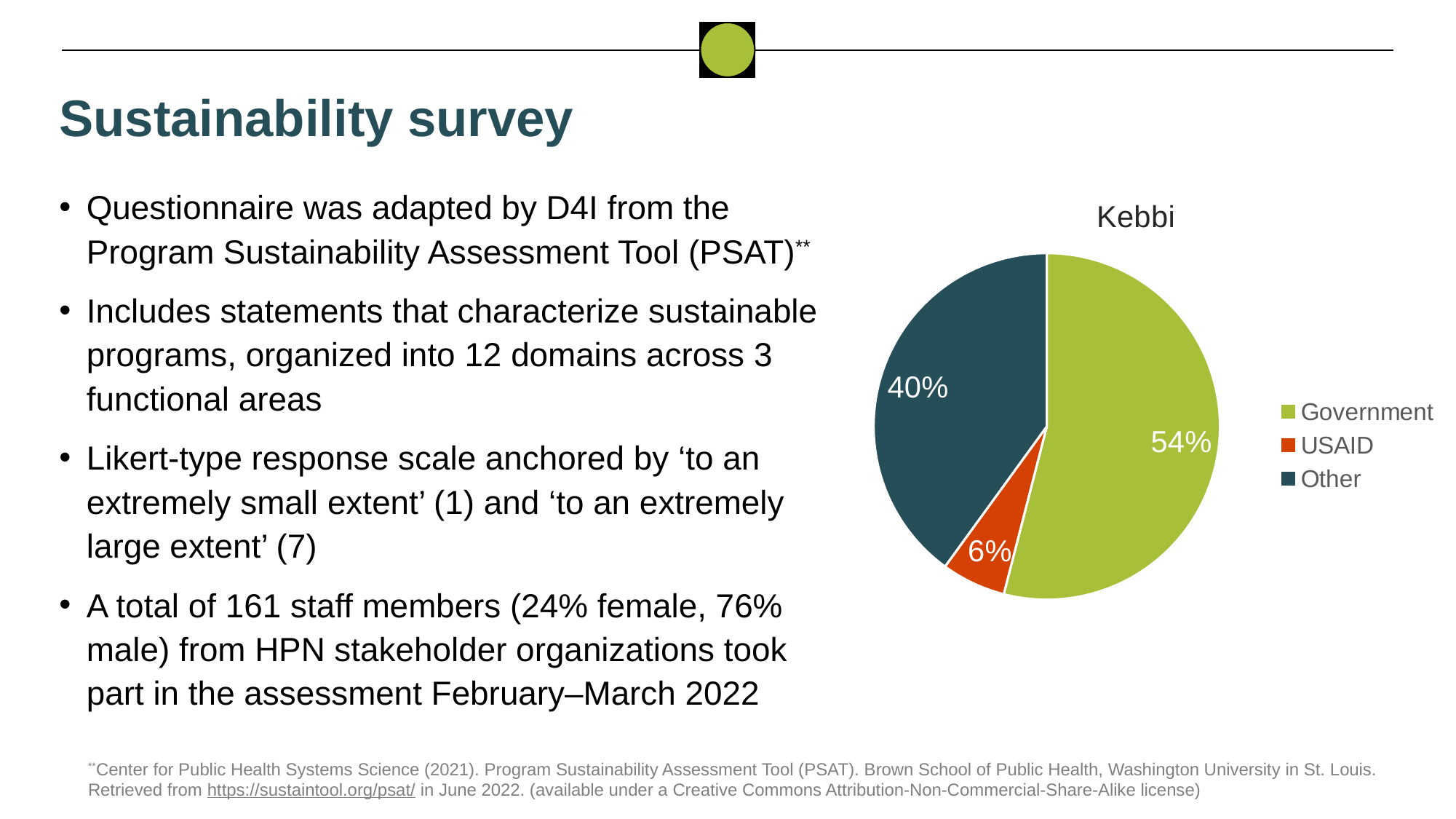
What type of chart is shown on the slide? pie chart How many entries does the legend list? 3 What share of the pie does Other represent? 40% What share of the pie does USAID represent? 6% Which category has the largest slice of the pie? Government Which category has the smallest slice of the pie? USAID What colour is the USAID slice? red What share of the pie does Government represent? 54% What is the title of the pie chart? Kebbi Which is larger, the Other slice or the USAID slice? Other How many categories does the pie chart show? 3 What is the difference in percentage points between the Government and Other slices? 14